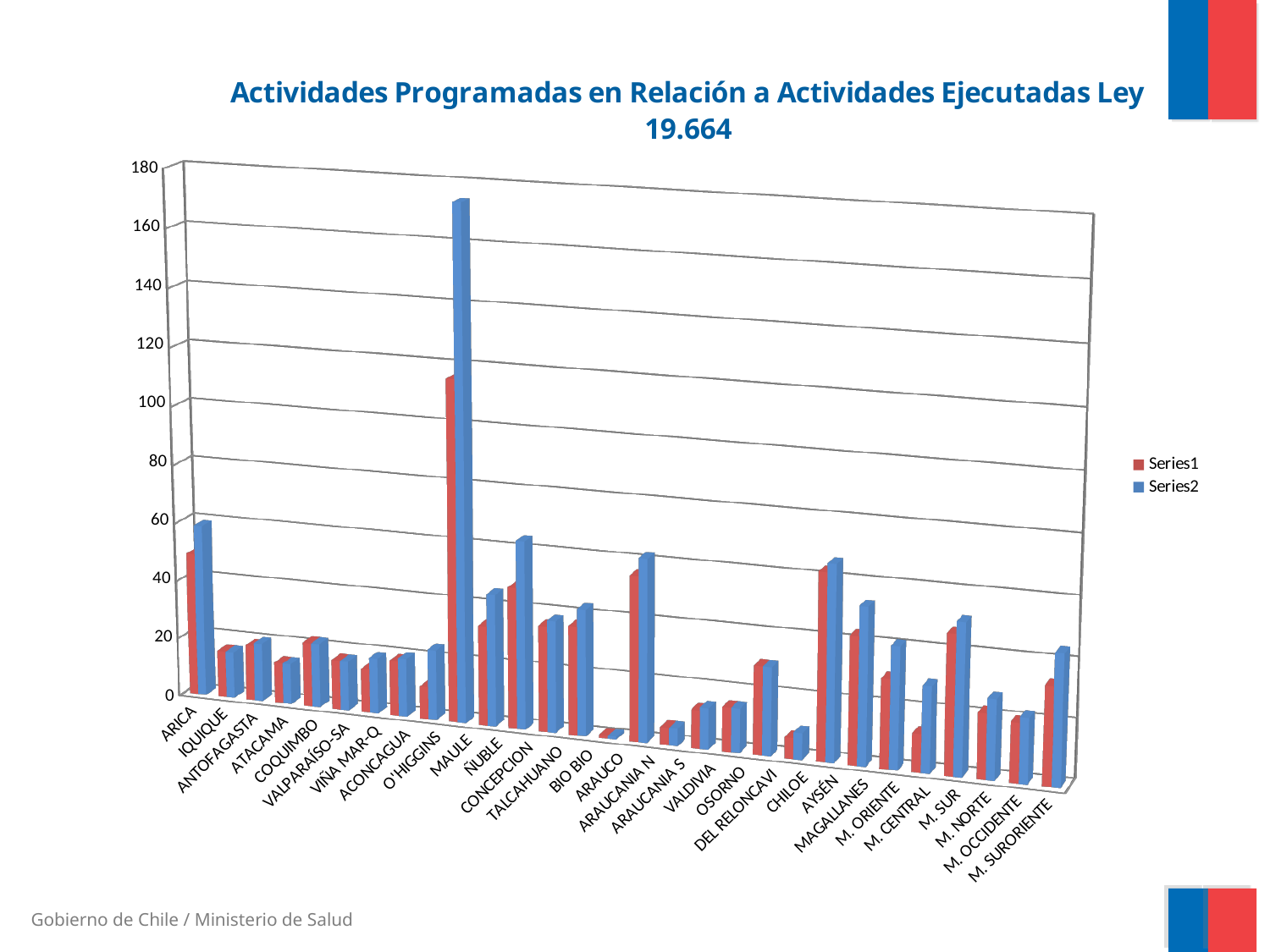
What is the title of the chart? Actividades Programadas en Relación a Actividades Ejecutadas Ley 19.664 Which category has the highest value for Series2? MAULE Is the Series1 value for MAULE greater or less than 80? greater Which has the larger Series2 value, MAULE or ARICA? MAULE Is the Series2 value for BIO BIO greater or less than 20? greater How many series does the legend list? 2 What kind of chart is shown on the slide? bar chart Which category has the highest value for Series1? MAULE Which category has the lowest value for Series2? ARAUCO Is the Series1 value for ARICA greater or less than 20? greater How many categories are shown along the x axis? 29